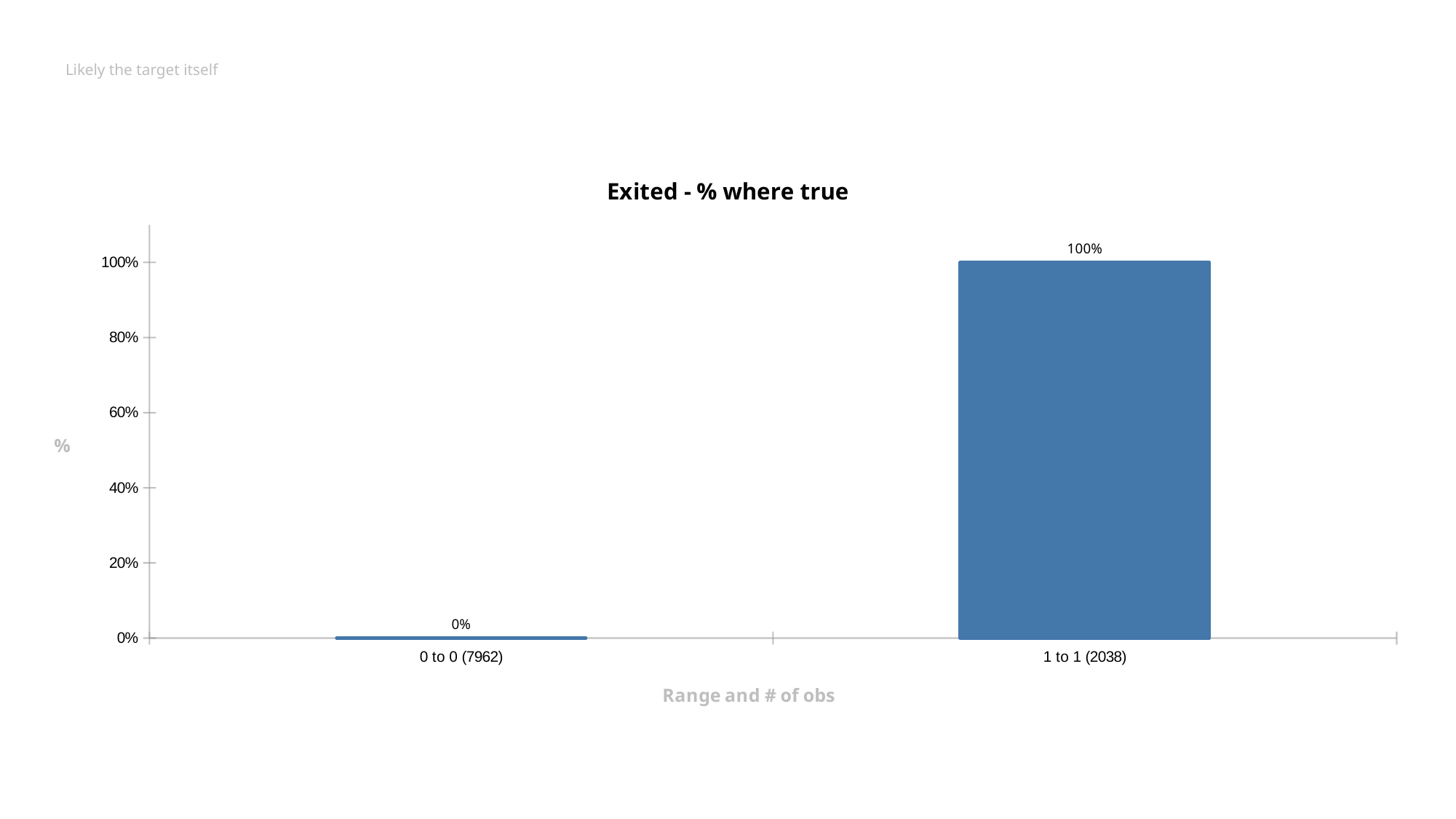
What is the label of the x axis? Range and # of obs Do the values rise or fall from left to right along the x axis? rise Which is larger, the value for "0 to 0 (7962)" or the value for "1 to 1 (2038)"? 1 to 1 (2038) What is the difference between the values for "1 to 1 (2038)" and "0 to 0 (7962)"? 100% Which category has the highest value? 1 to 1 (2038) What is the title of the chart? Exited - % where true What is the value for the category "1 to 1 (2038)"? 100% How many categories are shown on the x axis? 2 What kind of chart is shown on the slide? bar chart What is the value for the category "0 to 0 (7962)"? 0% Which category has the lowest value? 0 to 0 (7962) Is the value for "1 to 1 (2038)" greater or less than 60%? greater